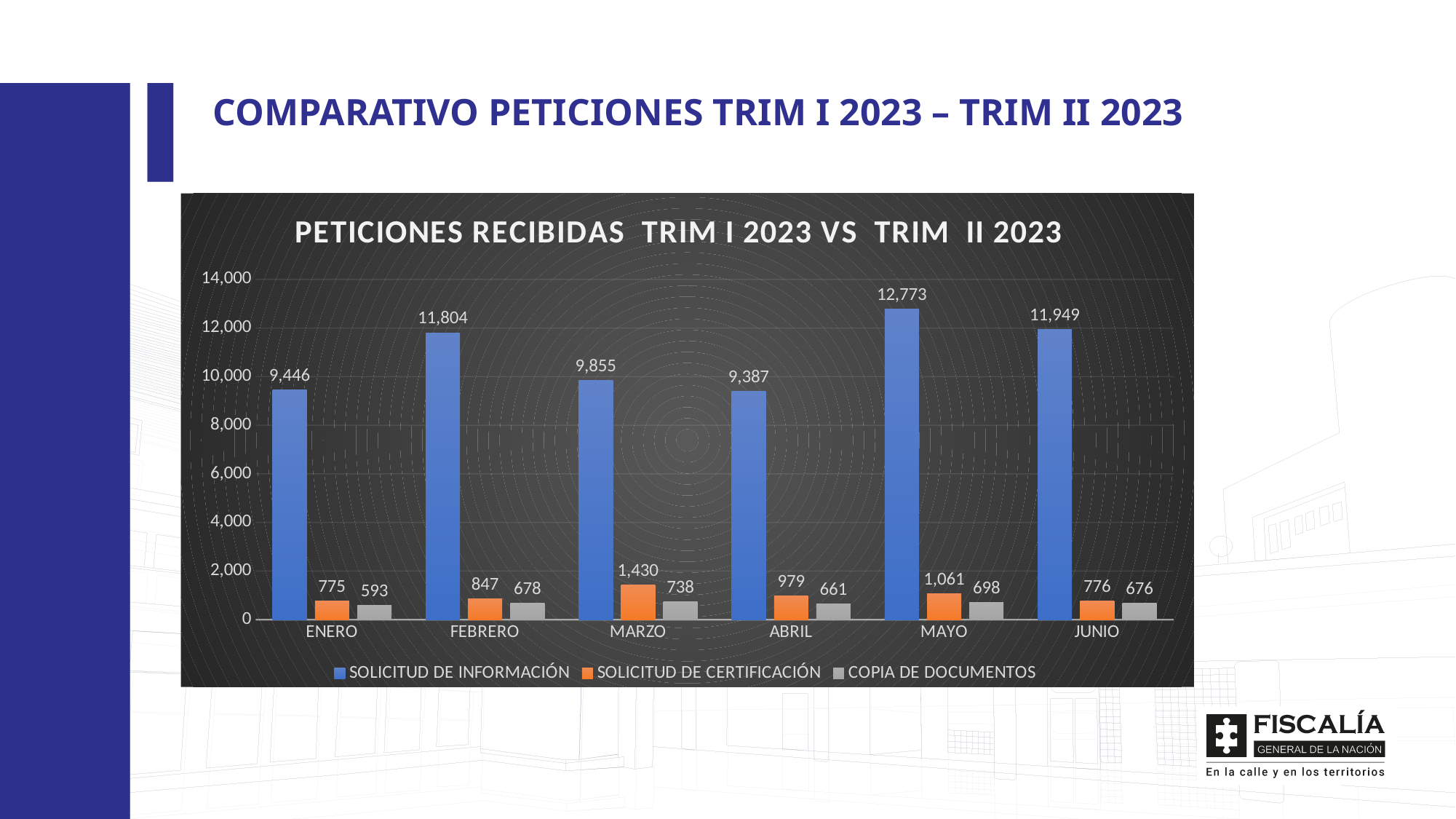
What is the difference between the SOLICITUD DE INFORMACIÓN values for FEBRERO and ENERO? 2,358 What is the value of COPIA DE DOCUMENTOS for ENERO? 593 Which month has the lowest value for COPIA DE DOCUMENTOS? ENERO What is the title of the chart? PETICIONES RECIBIDAS TRIM I 2023 VS TRIM II 2023 What kind of chart is shown on the slide? Bar chart How many months are shown on the x axis? 6 How many series does the legend list? 3 What is the value of SOLICITUD DE INFORMACIÓN for MAYO? 12,773 Which series is shown in orange? SOLICITUD DE CERTIFICACIÓN Which month has the highest value for SOLICITUD DE INFORMACIÓN? MAYO What is the value of SOLICITUD DE CERTIFICACIÓN for MARZO? 1,430 Which is larger, SOLICITUD DE CERTIFICACIÓN for ABRIL or for JUNIO? ABRIL